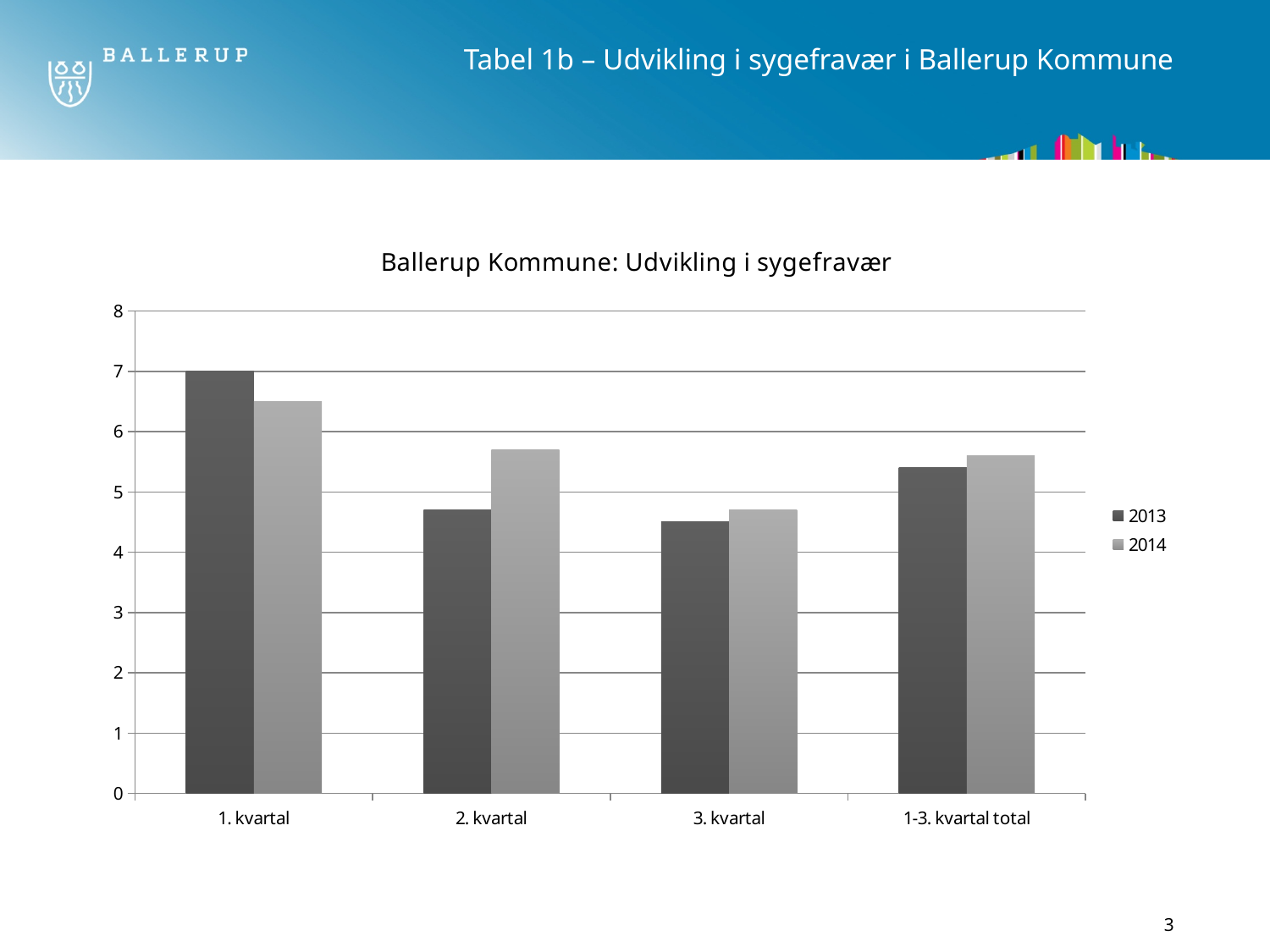
Is the value for 2014 in 1. kvartal greater or less than 6? greater Which category has the highest value for the 2014 series? 1. kvartal Which category has the lowest value for the 2014 series? 3. kvartal What is the title of the chart? Ballerup Kommune: Udvikling i sygefravær How many categories are shown on the x axis? 4 For 2. kvartal, which series has the larger value, 2013 or 2014? 2014 What kind of chart is shown on the slide? bar chart How many series does the legend list? 2 For 1. kvartal, which series has the larger value, 2013 or 2014? 2013 Which category has the highest value for the 2013 series? 1. kvartal Which category has the lowest value for the 2013 series? 3. kvartal Is the value for 2013 in 3. kvartal greater or less than 5? less